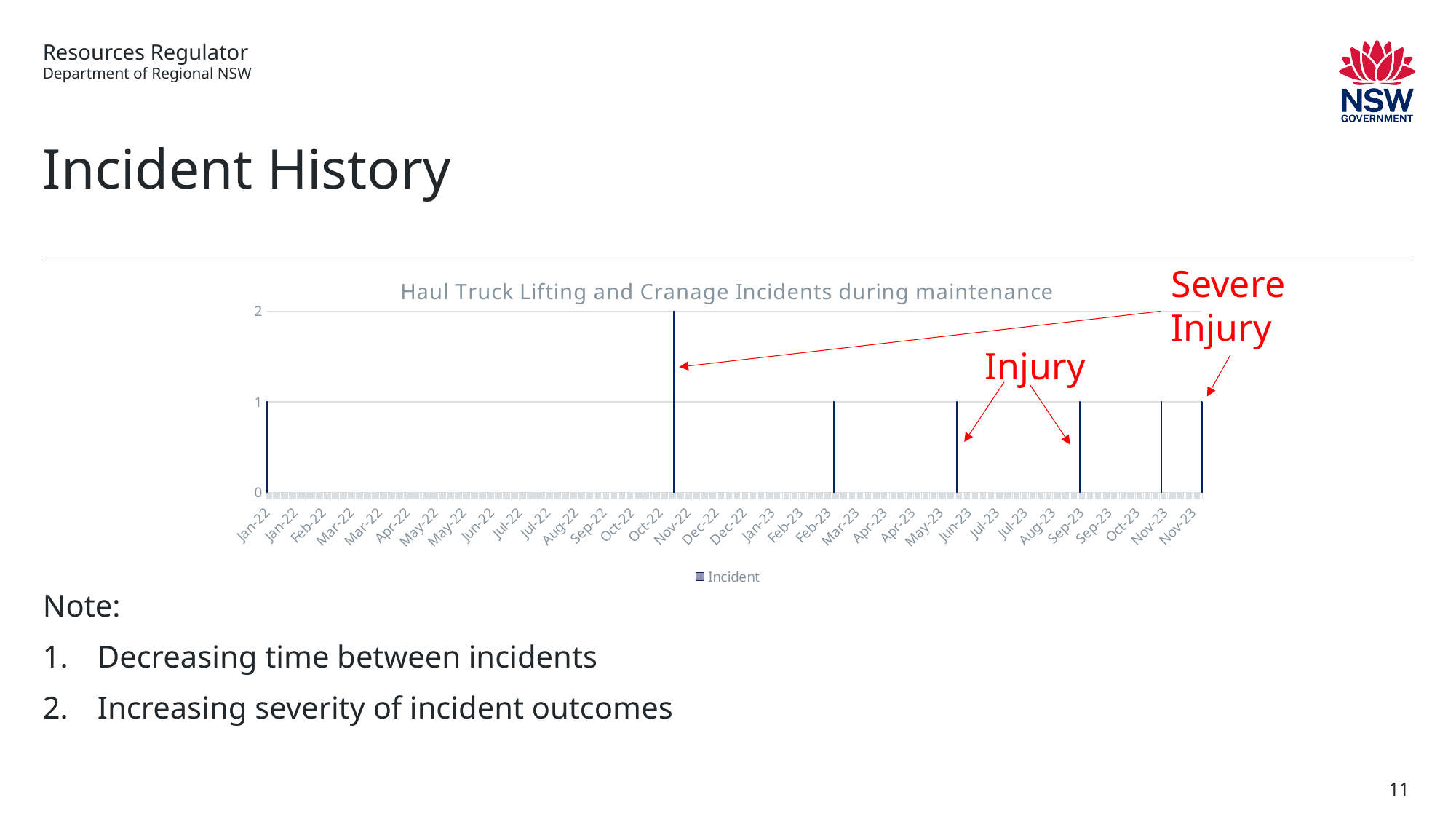
What is the difference between the Incident value for Nov-22 and the Incident value for Sep-23? 1 Which month has the highest number of incidents in the chart? Nov-22 What kind of chart is shown on the slide? Bar chart Is the Incident value for Nov-22 greater or less than 1? greater What is the title of the chart? Haul Truck Lifting and Cranage Incidents during maintenance What is the value of the Incident bar for Nov-22? 2 Which is larger, the Incident value for Nov-22 or for Jun-23? Nov-22 Which bar is annotated with the label 'Severe Injury'? The last bar, Nov-23 How many series does the chart legend list? 1 How many bars (incidents with a non-zero value) are plotted in the chart? 7 What is the value of the Incident bar for Mar-23? 1 What is the value of the Incident bar for Jan-22? 1